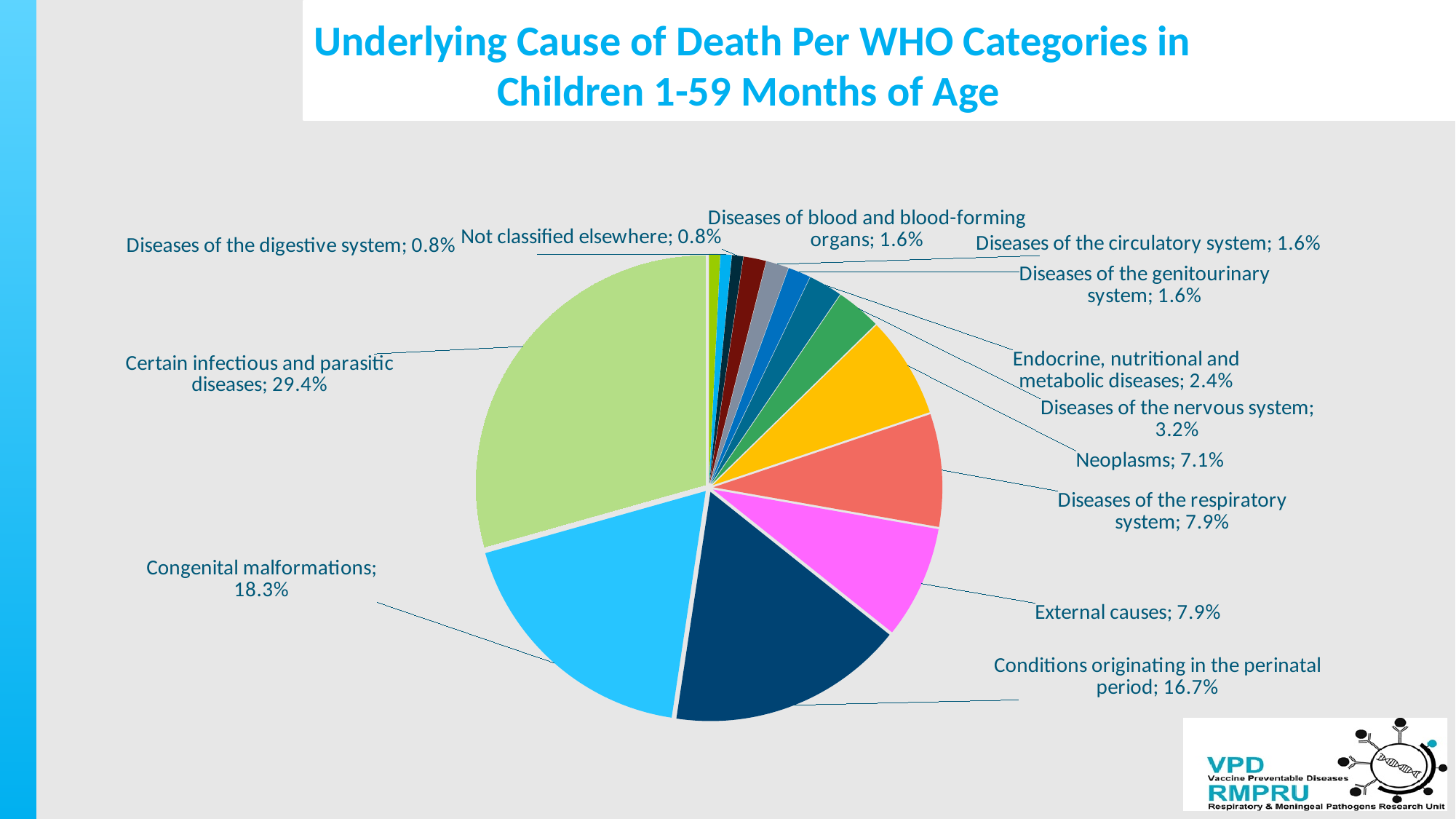
How many categories are shown in the pie chart? 14 What percentage is shown for Diseases of the nervous system? 3.2% What percentage is shown for Certain infectious and parasitic diseases? 29.4% What is the difference in percentage points between Certain infectious and parasitic diseases and Congenital malformations? 11.1 What percentage is shown for Conditions originating in the perinatal period? 16.7% What type of chart is shown on the slide? Pie chart Which is larger, the share for Neoplasms or the share for Diseases of the respiratory system? Diseases of the respiratory system What percentage is shown for Congenital malformations? 18.3% What percentage is shown for Neoplasms? 7.1% Which category has the largest share of the pie? Certain infectious and parasitic diseases What is the difference in percentage points between Conditions originating in the perinatal period and External causes? 8.8 What is the title of the chart? Underlying Cause of Death Per WHO Categories in Children 1-59 Months of Age